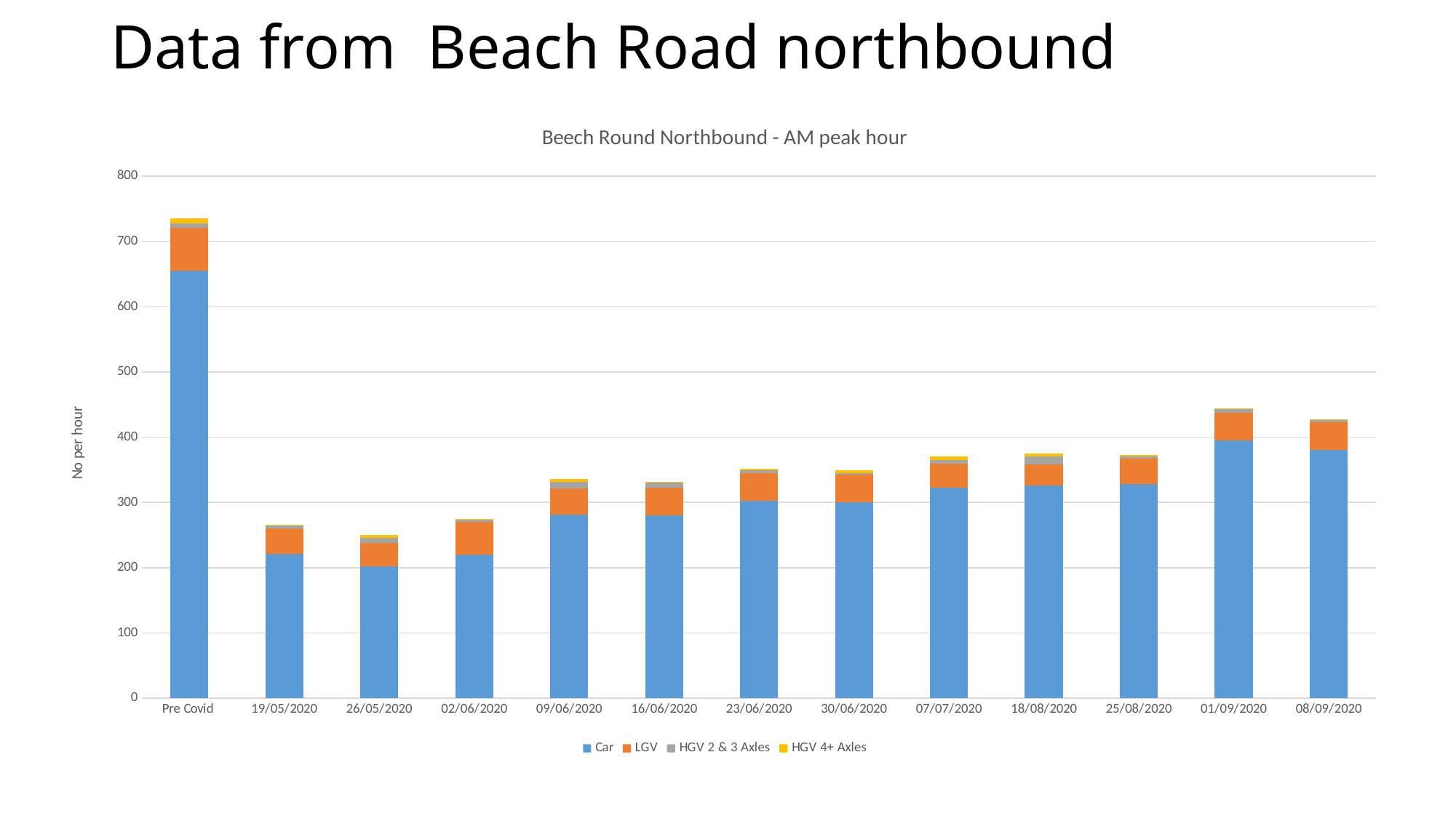
Which has the larger total bar, 01/09/2020 or 08/09/2020? 01/09/2020 Is the total for 01/09/2020 greater or less than 400? greater What is the title of the chart? Beech Round Northbound - AM peak hour Is the total for Pre Covid greater or less than 700? greater How many series does the legend list? 4 Which category has the highest total bar? Pre Covid Is the total for 19/05/2020 greater or less than 300? less Which category has the lowest total bar? 26/05/2020 What is the label on the vertical axis? No per hour What kind of chart is shown on the slide? Stacked bar chart How many categories are shown on the x axis? 13